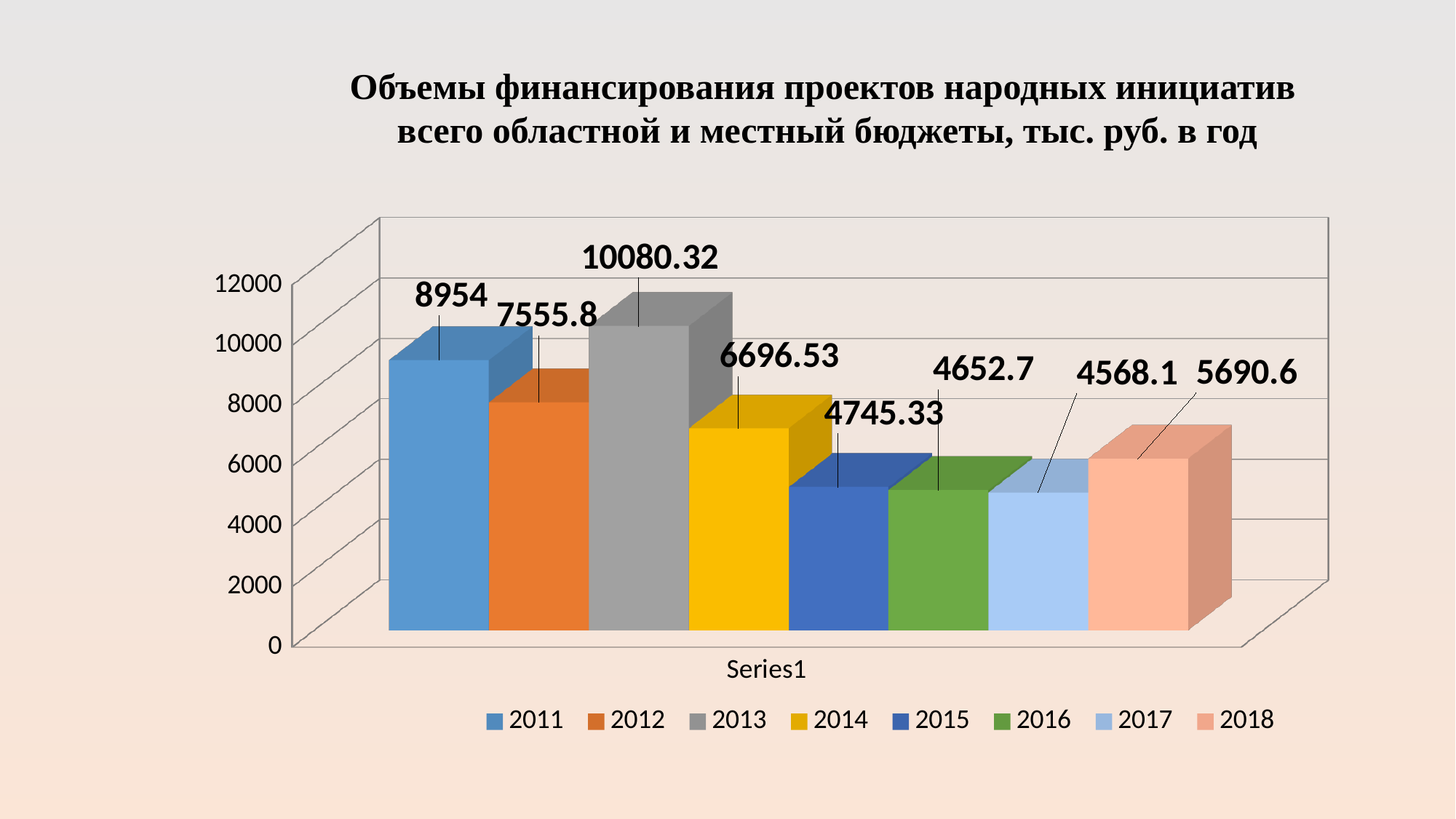
What is the difference between the values for 2018 and 2017? 1122.5 Which year has the highest value? 2013 What is the value for 2013? 10080.32 What is the value for 2011? 8954 What is the value for 2018? 5690.6 What is the difference between the values for 2013 and 2011? 1126.32 Which year has the lowest value? 2017 What is the value for 2017? 4568.1 How many entries does the legend list? 8 How many bars are shown in the chart? 8 What kind of chart is shown on the slide? bar chart Which is larger, the value for 2012 or the value for 2014? 2012